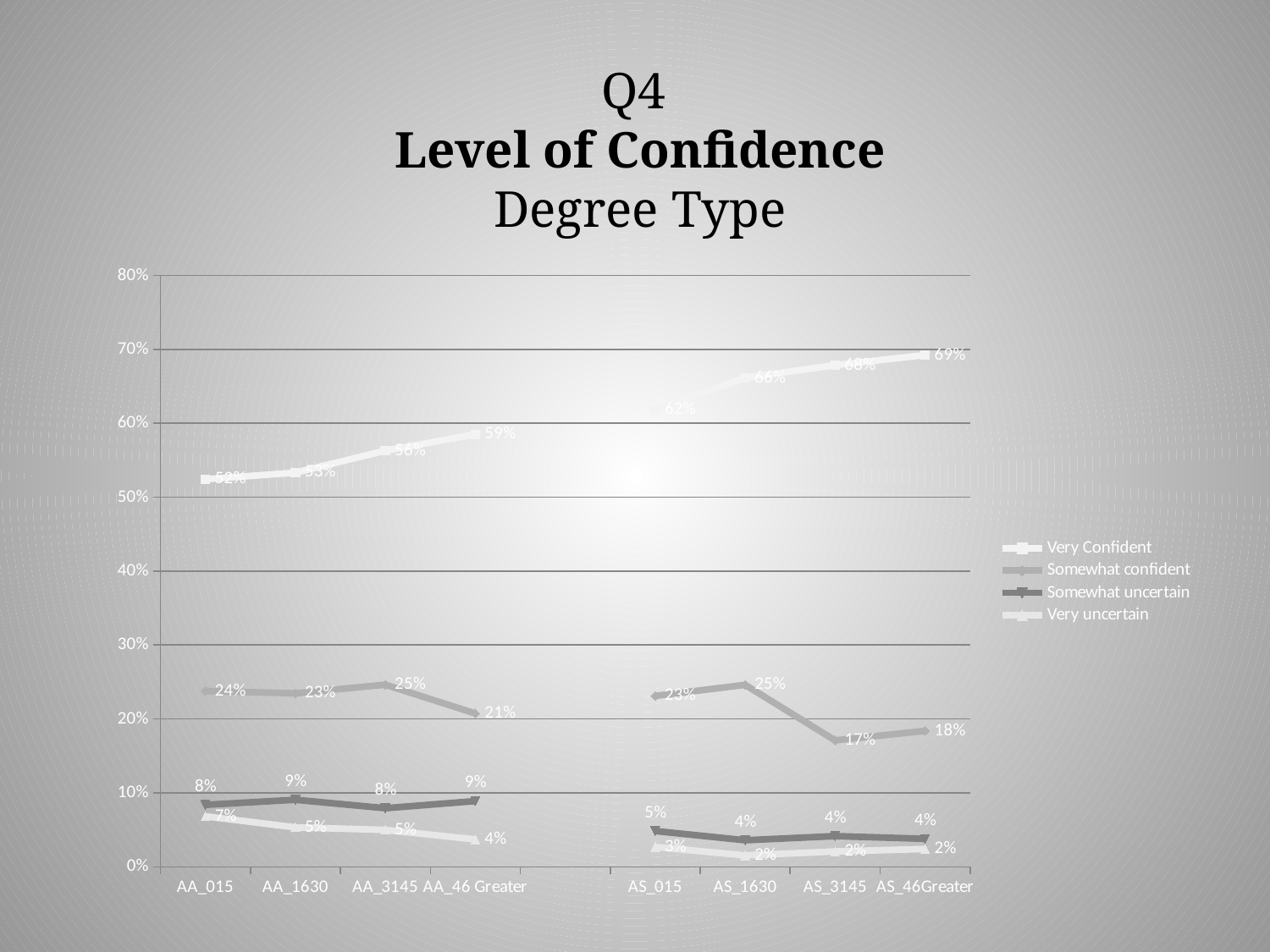
Which is larger, the Somewhat uncertain value for AA_1630 or for AS_1630? AA_1630 What is the Very Confident value for AS_46Greater? 69% What kind of chart is shown on the slide? Line chart How many labeled categories are shown on the x axis? 8 What is the Very uncertain value for AA_015? 7% What is the difference between the Very Confident values for AS_46Greater and AA_015? 17 percentage points What is the Somewhat confident value for AA_3145? 25% For which category is the Very Confident series highest? AS_46Greater How many series does the legend list? 4 Does the Very Confident series rise or fall from AA_015 to AA_46 Greater? Rises Is the Very Confident value for AA_3145 greater or less than 60%? less For which category is the Somewhat confident series lowest? AS_3145